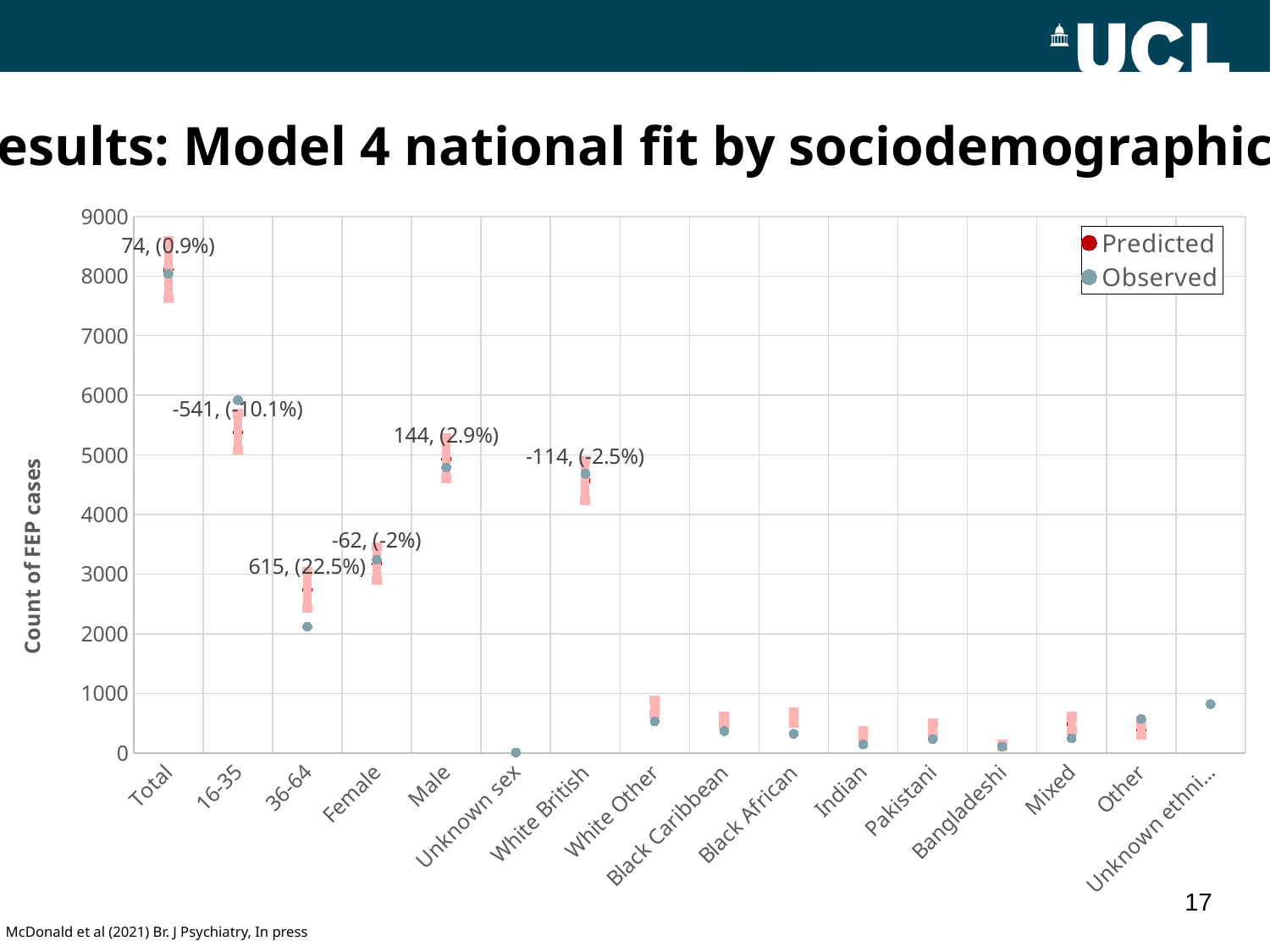
How many categories are shown along the x axis? 16 How many series does the legend list? 2 What data label is printed next to the 16-35 category? -541, (-10.1%) Which category has the highest Observed value? Total What are the two series named in the legend? Predicted and Observed What data label is printed next to the Total category? 74, (0.9%) Is the Observed value for Total greater or less than 7000? greater What data label is printed next to the White British category? -114, (-2.5%) What data label is printed next to the Male category? 144, (2.9%) What data label is printed next to the 36-64 category? 615, (22.5%) What is the title of the y axis? Count of FEP cases What kind of chart is shown on the slide? Scatter (dot) chart